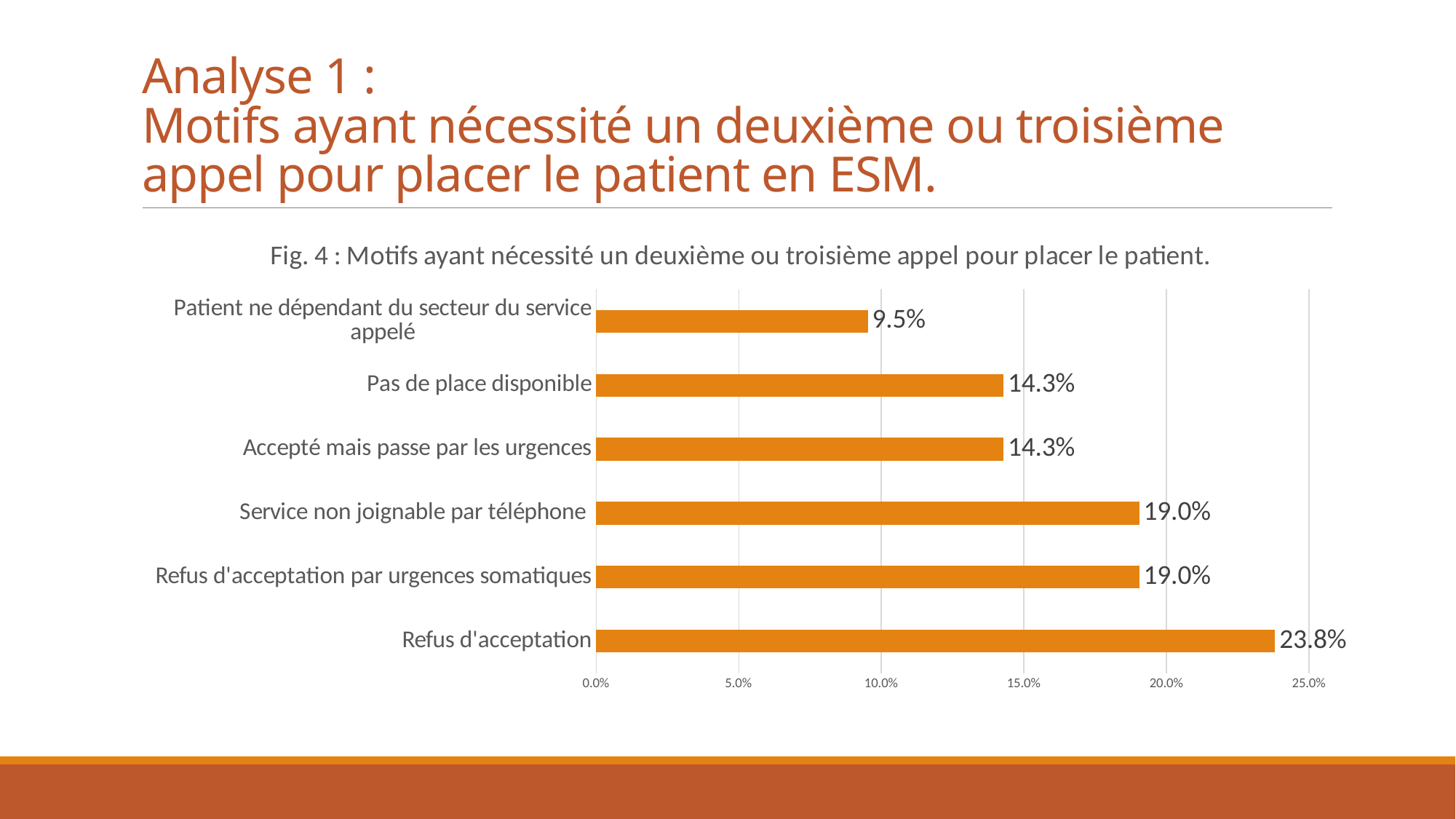
How many categories are shown in the chart? 6 What kind of chart is shown on the slide? Bar chart What is the value for "Patient ne dépendant du secteur du service appelé"? 9.5% What is the value for "Service non joignable par téléphone"? 19.0% Which category has the highest value? Refus d'acceptation What is the value for "Refus d'acceptation"? 23.8% Which is larger, the value for "Service non joignable par téléphone" or the value for "Accepté mais passe par les urgences"? Service non joignable par téléphone What is the difference between the values for "Pas de place disponible" and "Patient ne dépendant du secteur du service appelé"? 4.8% What is the title of the chart? Fig. 4 : Motifs ayant nécessité un deuxième ou troisième appel pour placer le patient. What is the difference between the values for "Refus d'acceptation" and "Refus d'acceptation par urgences somatiques"? 4.8% Which category has the lowest value? Patient ne dépendant du secteur du service appelé What is the value for "Pas de place disponible"? 14.3%